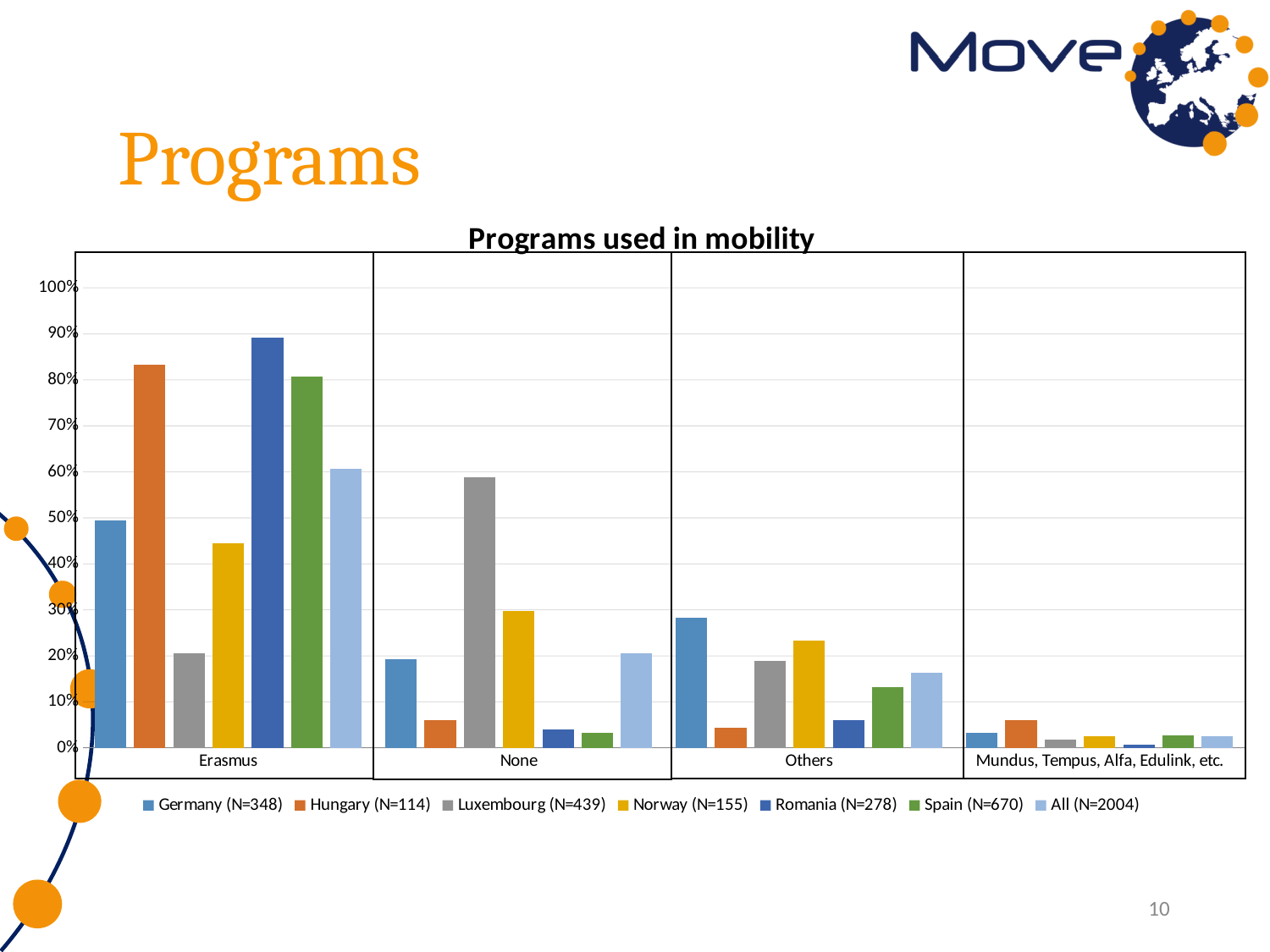
Is the value for Luxembourg (N=439) in the None category greater or less than 50%? greater In the Erasmus category, which is larger: Germany (N=348) or Luxembourg (N=439)? Germany (N=348) What is the title of the chart? Programs used in mobility In the Others category, which is larger: Germany (N=348) or Spain (N=670)? Germany (N=348) Which series has the lowest value for Erasmus? Luxembourg (N=439) How many program categories are shown on the x axis? 4 Which country has the highest value for Erasmus? Romania (N=278) Which series has the highest value for None? Luxembourg (N=439) How many series does the legend list? 7 What kind of chart is shown on the slide? bar chart Is the value for Spain (N=670) in the Erasmus category greater or less than 70%? greater Is the value for Germany (N=348) in the Erasmus category greater or less than 40%? greater